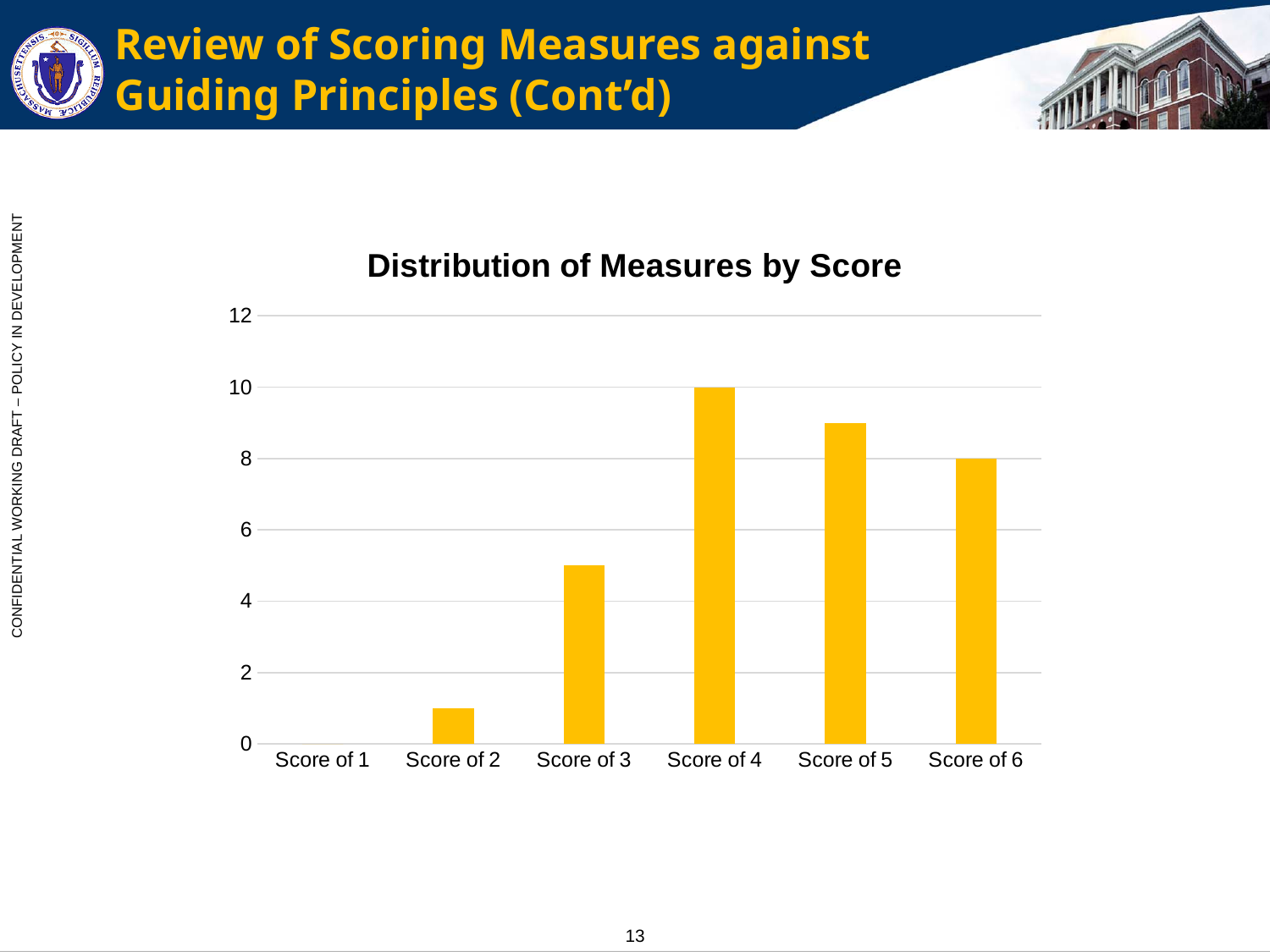
Which is larger, the value for Score of 3 or the value for Score of 6? Score of 6 How many score categories are shown on the x axis? 6 Is the value for Score of 5 greater or less than 8? greater What is the title of the chart? Distribution of Measures by Score What is the value for Score of 4? 10 What kind of chart is shown on the slide? bar chart Is the value for Score of 3 greater or less than 4? greater Is the value for Score of 2 greater or less than 2? less Which score category has the highest number of measures? Score of 4 What is the difference between the values for Score of 4 and Score of 6? 2 What is the value for Score of 6? 8 Which score category has the lowest number of measures? Score of 1